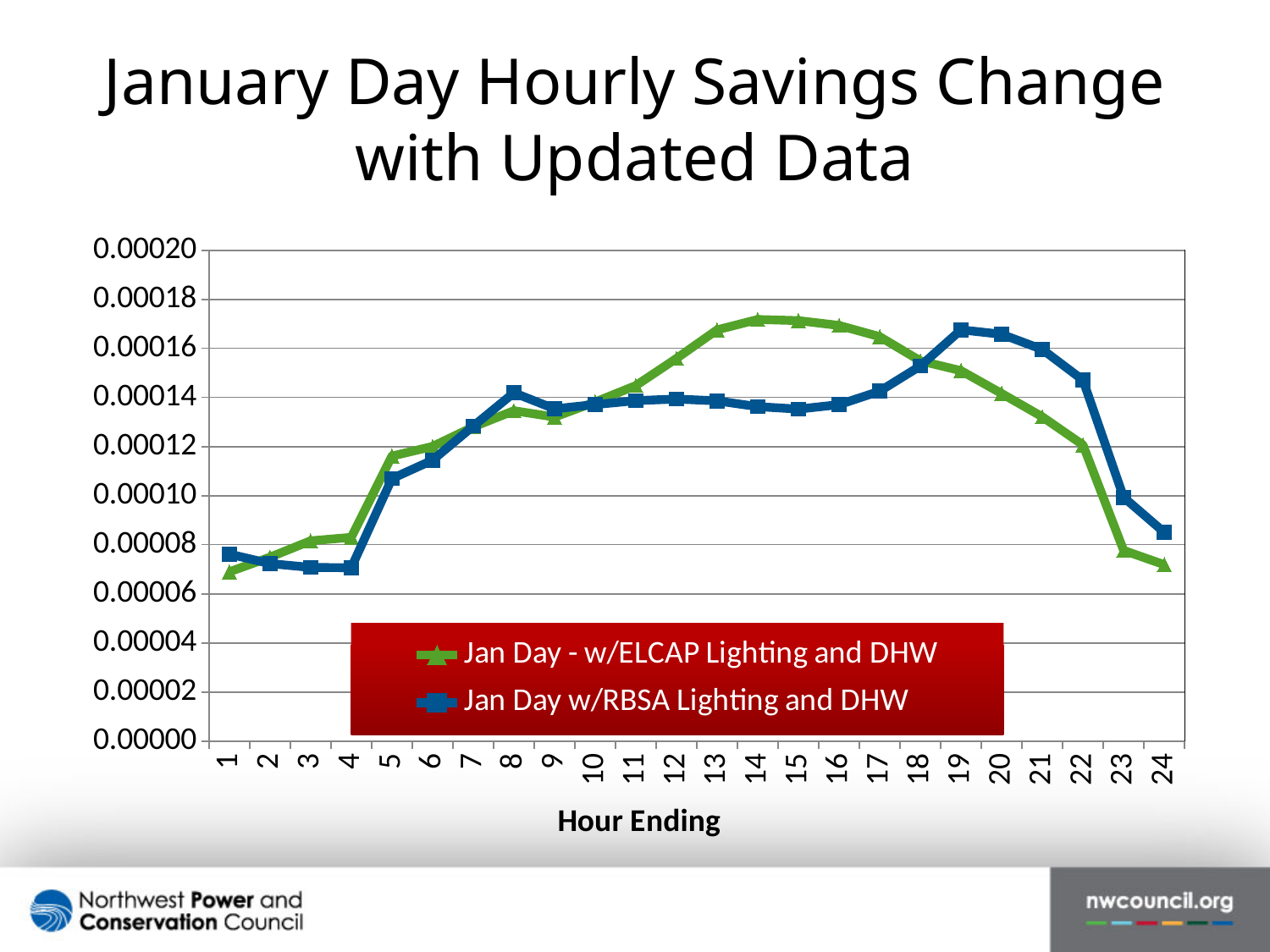
Is the value for Jan Day - w/ELCAP Lighting and DHW at hour 24 greater or less than 0.00008? less At which hour does the Jan Day w/RBSA Lighting and DHW series reach its highest value? 19 At hour 14, which series has the higher value? Jan Day - w/ELCAP Lighting and DHW At hour 20, which series has the higher value? Jan Day w/RBSA Lighting and DHW Is the value for Jan Day - w/ELCAP Lighting and DHW at hour 14 greater or less than 0.00016? greater How many series does the legend list? 2 How many hours are plotted along the x axis? 24 Do the values for Jan Day - w/ELCAP Lighting and DHW rise or fall from hour 21 to hour 24? fall What kind of chart is shown on the slide? Line chart What is the title of the x axis? Hour Ending Which series is drawn in blue with square markers? Jan Day w/RBSA Lighting and DHW Is the value for Jan Day w/RBSA Lighting and DHW at hour 1 greater or less than 0.00008? less